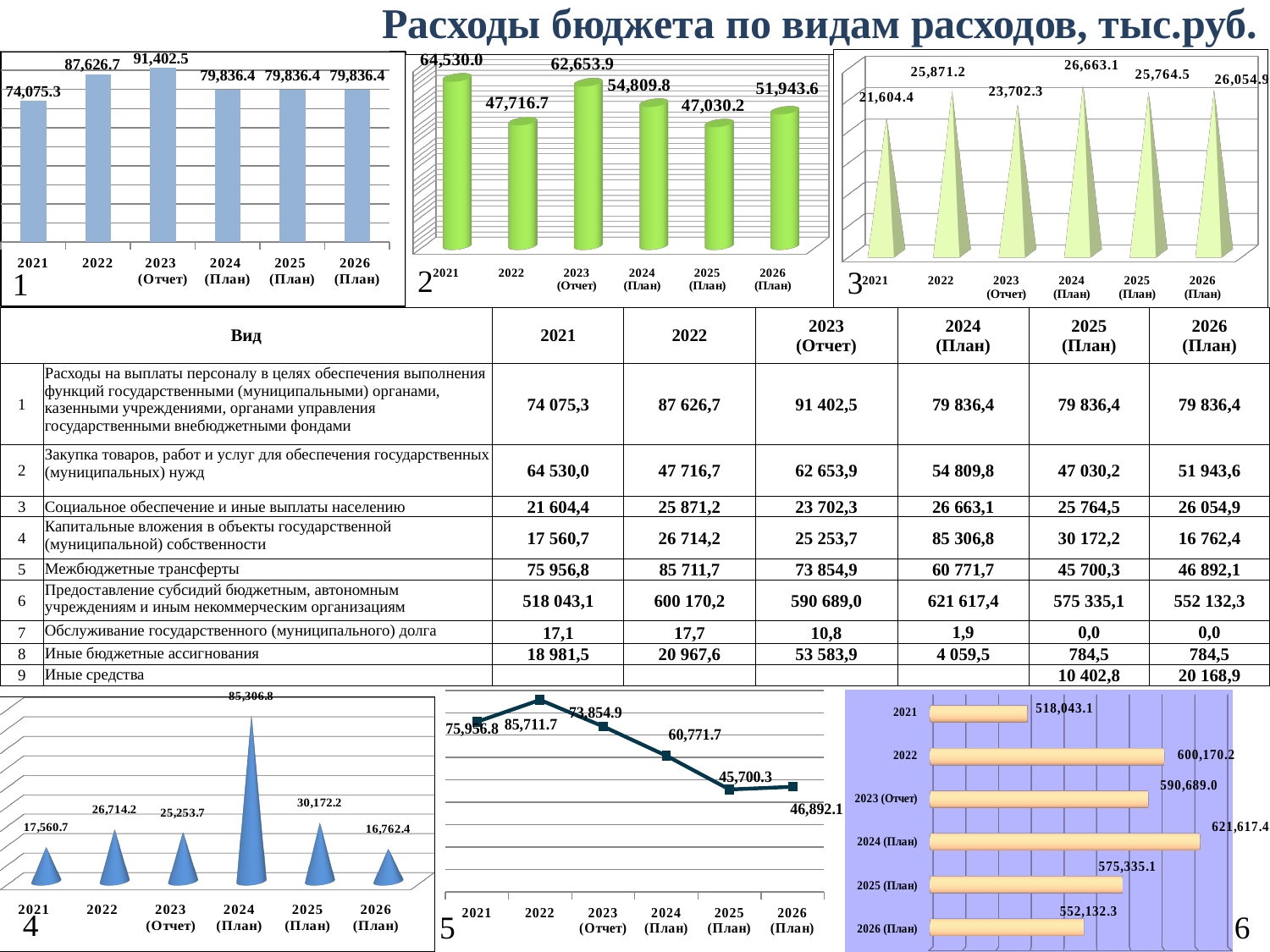
In chart 6 (bottom-right), which is larger, the value for 2022 or the value for 2023 (Отчет)? 2022 In chart 4 (bottom-left), what is the value for 2026 (План)? 16,762.4 In chart 6 (bottom-right), what is the value for 2024 (План)? 621,617.4 In chart 1 (top-left), what is the value for 2023 (Отчет)? 91,402.5 In chart 2 (top-middle), what is the value for 2025 (План)? 47,030.2 In chart 2 (top-middle), which year has the highest value? 2021 In chart 4 (bottom-left), which year has the highest value? 2024 (План) In chart 1 (top-left), which year has the lowest value? 2021 How many categories are shown on the x axis of chart 1 (top-left)? 6 In chart 3 (top-right), what is the difference between the values for 2024 (План) and 2021? 5,058.7 In chart 5 (bottom-middle), do the values generally rise or fall from 2022 to 2025 (План)? fall What kind of chart is chart 5 (bottom-middle)? line chart